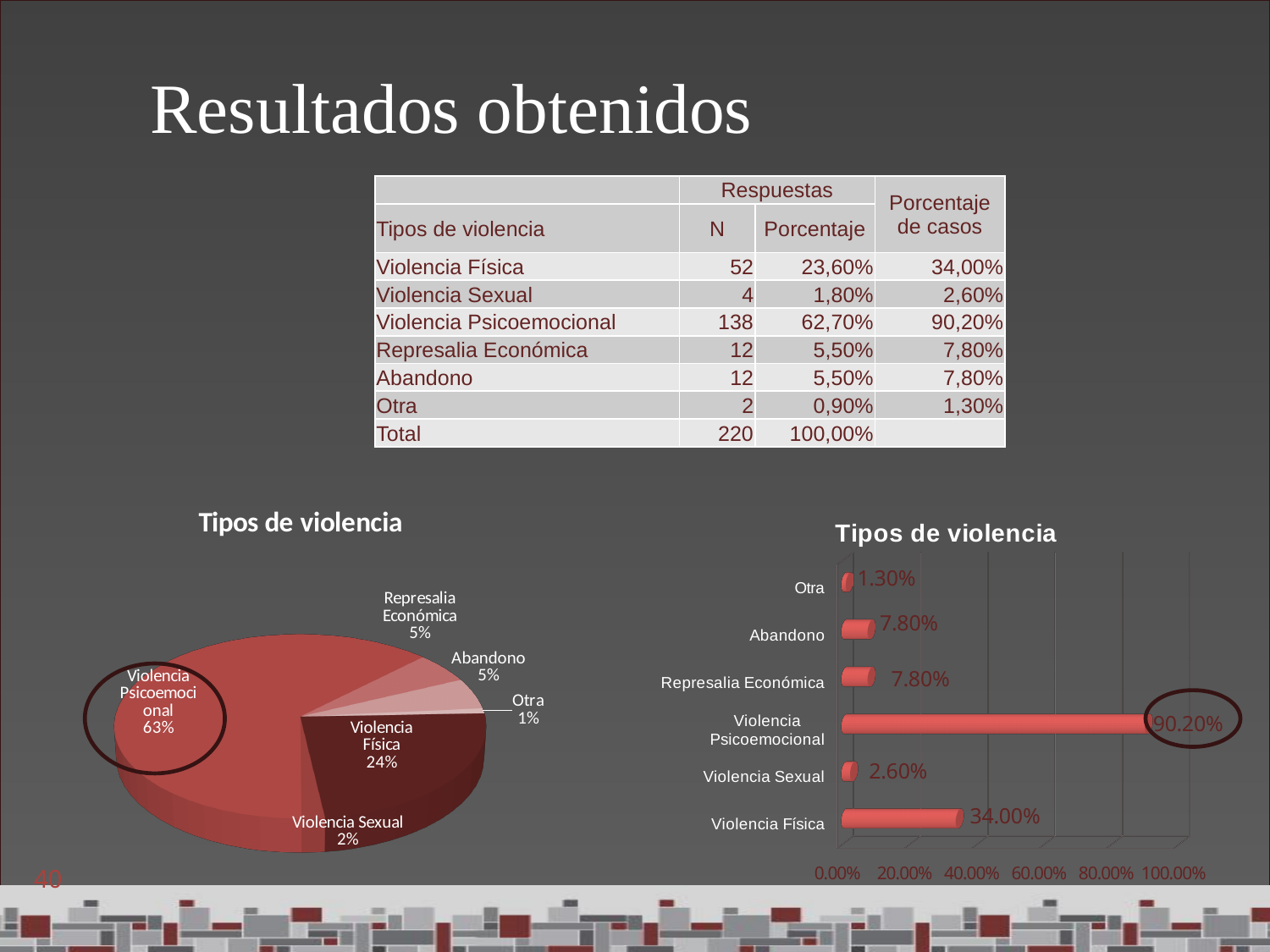
In the bar chart on the right, what is the value for Violencia Física? 34.00% In the bar chart on the right, what is the value for Violencia Psicoemocional? 90.20% In the bar chart on the right, which is larger, the value for Violencia Sexual or the value for Abandono? Abandono What kind of chart is the chart on the left of the slide? Pie chart In the bar chart on the right, what is the value for Otra? 1.30% In the bar chart on the right, what is the difference between the values for Violencia Psicoemocional and Violencia Física? 56.20% What kind of chart is the chart on the right of the slide? Bar chart In the pie chart on the left, what share does Violencia Física have? 24% How many categories are shown in the bar chart on the right? 6 In the pie chart on the left, what share does Violencia Psicoemocional have? 63% In the bar chart on the right, which category has the lowest value? Otra In the bar chart on the right, which category has the highest value? Violencia Psicoemocional